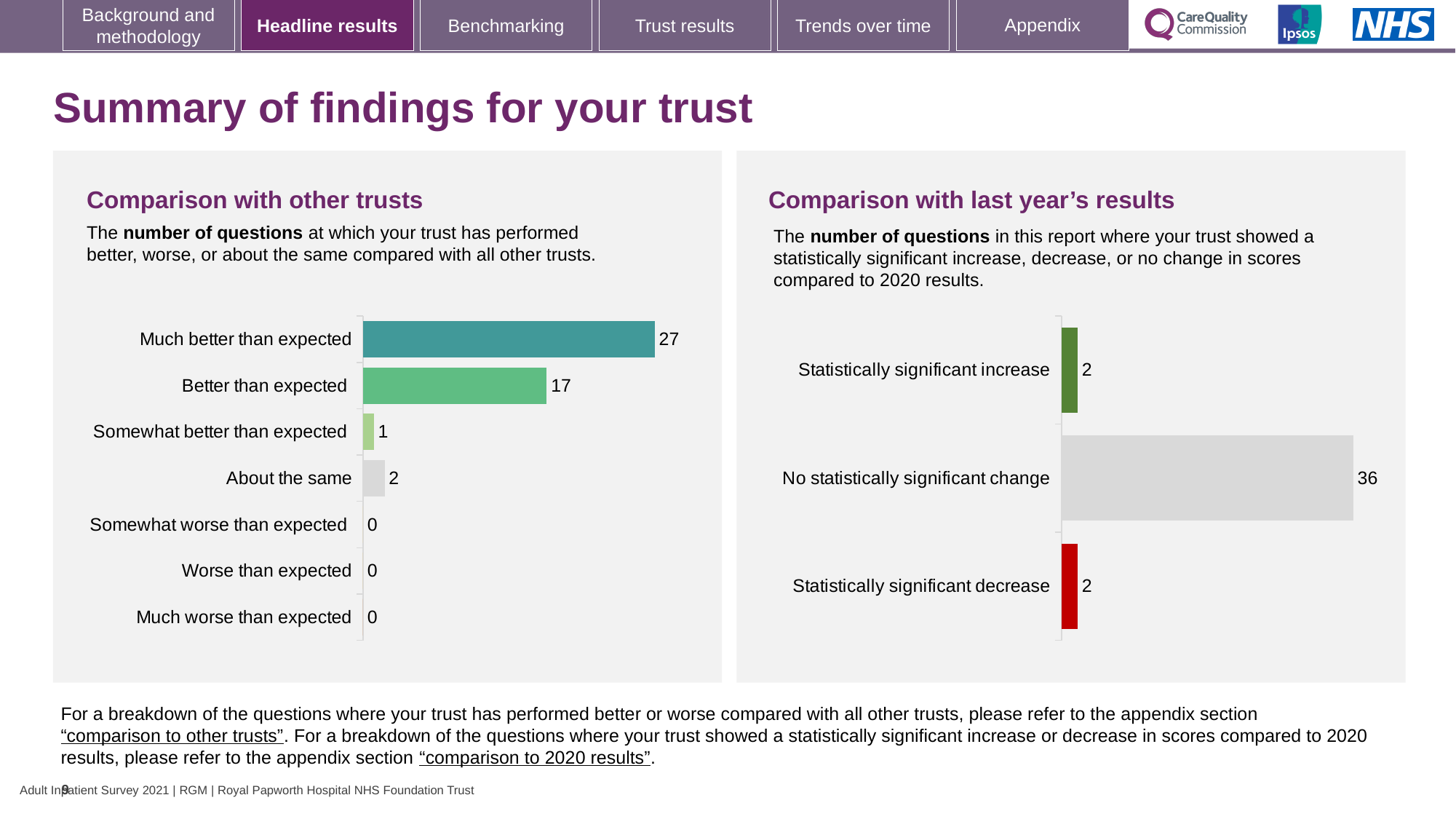
In the 'Comparison with last year's results' chart, what is the value for 'No statistically significant change'? 36 In the 'Comparison with other trusts' chart, what is the value for 'About the same'? 2 What type of chart is used in the 'Comparison with last year's results' panel? Bar chart In the 'Comparison with other trusts' chart, how many categories are shown? 7 In the 'Comparison with other trusts' chart, which category has the highest value? Much better than expected In the 'Comparison with last year's results' chart, which category has the highest value? No statistically significant change In the 'Comparison with last year's results' chart, what is the value for 'Statistically significant decrease'? 2 In the 'Comparison with other trusts' chart, what is the value for 'Better than expected'? 17 In the 'Comparison with other trusts' chart, how many categories have a value of 0? 3 In the 'Comparison with other trusts' chart, what is the value for 'Much better than expected'? 27 In the 'Comparison with last year's results' chart, what is the total of all three categories? 40 In the 'Comparison with other trusts' chart, what is the difference between 'Much better than expected' and 'Better than expected'? 10